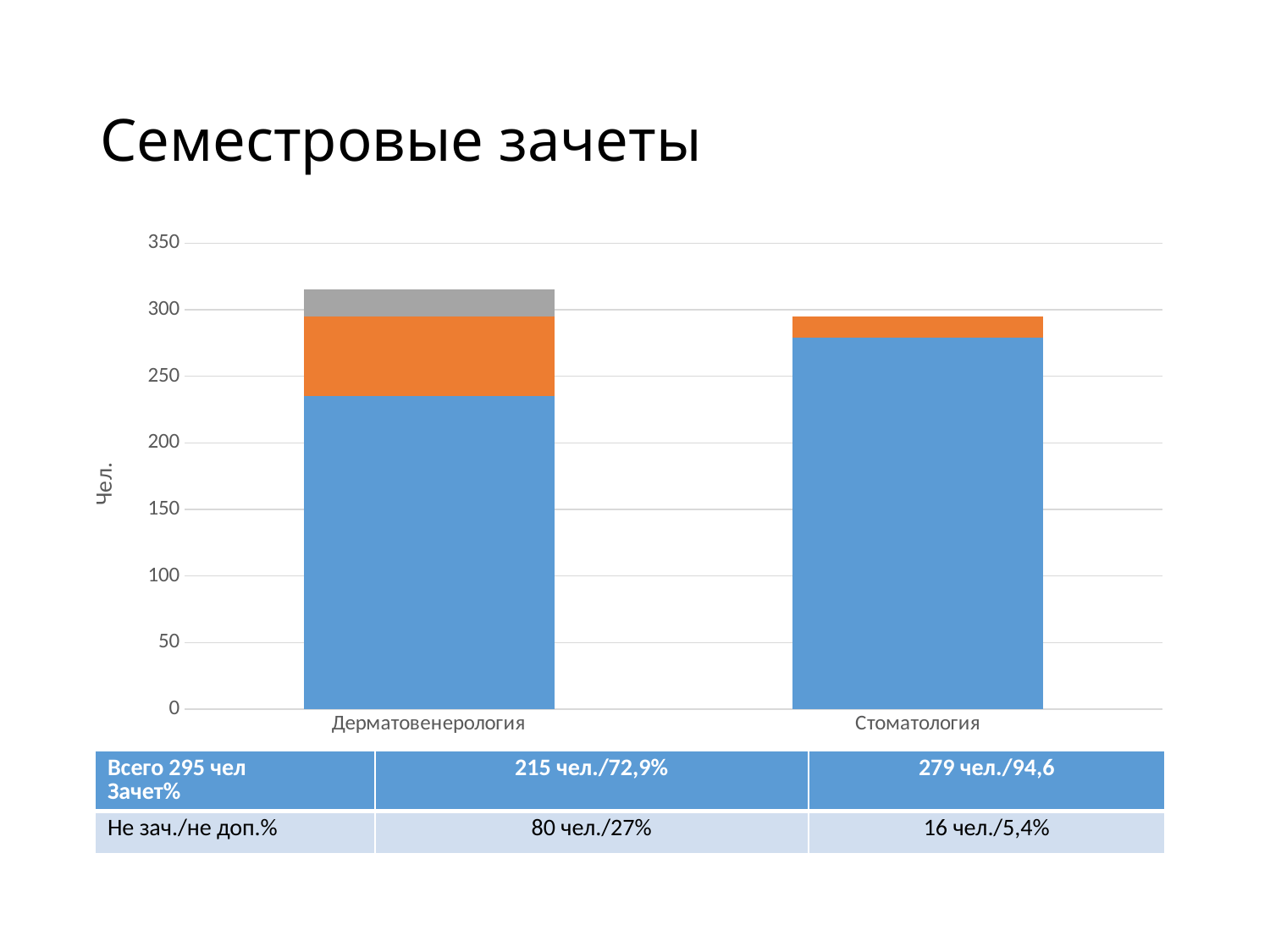
What kind of chart is shown on the slide? bar chart Is the total height of the stacked bar for Стоматология greater or less than 250? greater Is the blue segment for Дерматовенерология greater or less than 200? greater What is the label on the vertical axis of the chart? Чел. What is the title of the slide above the chart? Семестровые зачеты Which category has the larger orange segment, Дерматовенерология or Стоматология? Дерматовенерология How many categories are shown on the x axis of the chart? 2 Is the orange segment for Стоматология greater or less than 50? less Which category has the taller stacked bar overall? Дерматовенерология Which category has the taller blue segment, Дерматовенерология or Стоматология? Стоматология